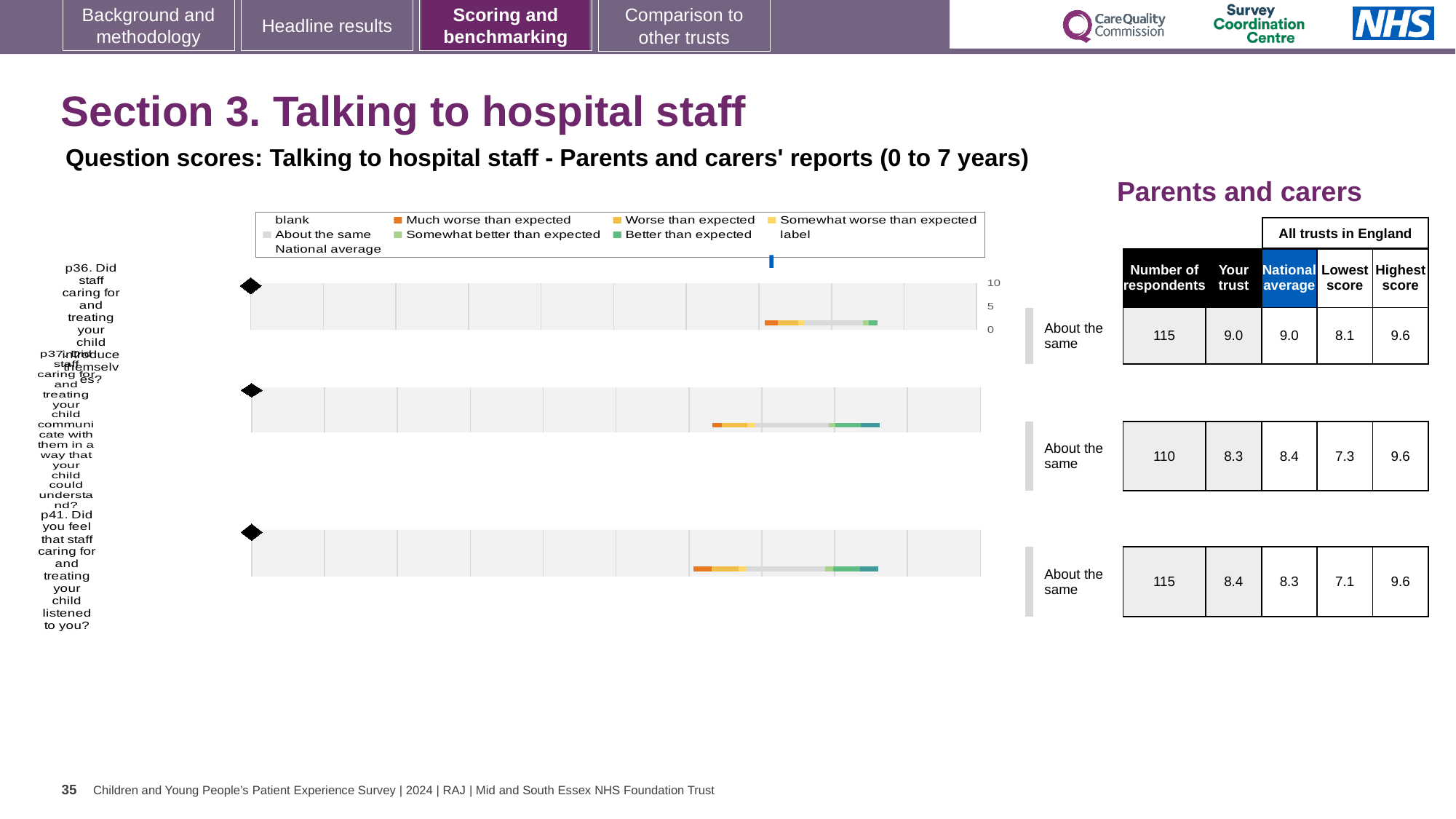
Which of the three questions has the highest 'Your trust' score? p36 How many question charts are shown on the slide? 3 For the p36 chart, what is the difference between the highest score and the lowest score across all trusts in England? 1.5 For the p41 chart, which is larger: the 'Your trust' score or the national average? Your trust What benchmark category is shown next to the p37 chart? About the same For the p36 chart (staff introducing themselves), what is the 'Your trust' score shown in the table? 9.0 What is the highest tick value shown on the chart axis? 10 For the p37 chart (communicating in a way your child could understand), what is the national average score? 8.4 Which of the three questions has the lowest 'Lowest score' value? p41 In the chart legend, which category is shown in orange? Much worse than expected What kind of chart is used to show the question scores on this slide? bar chart For the p41 chart (staff listened to you), how many respondents are shown? 115